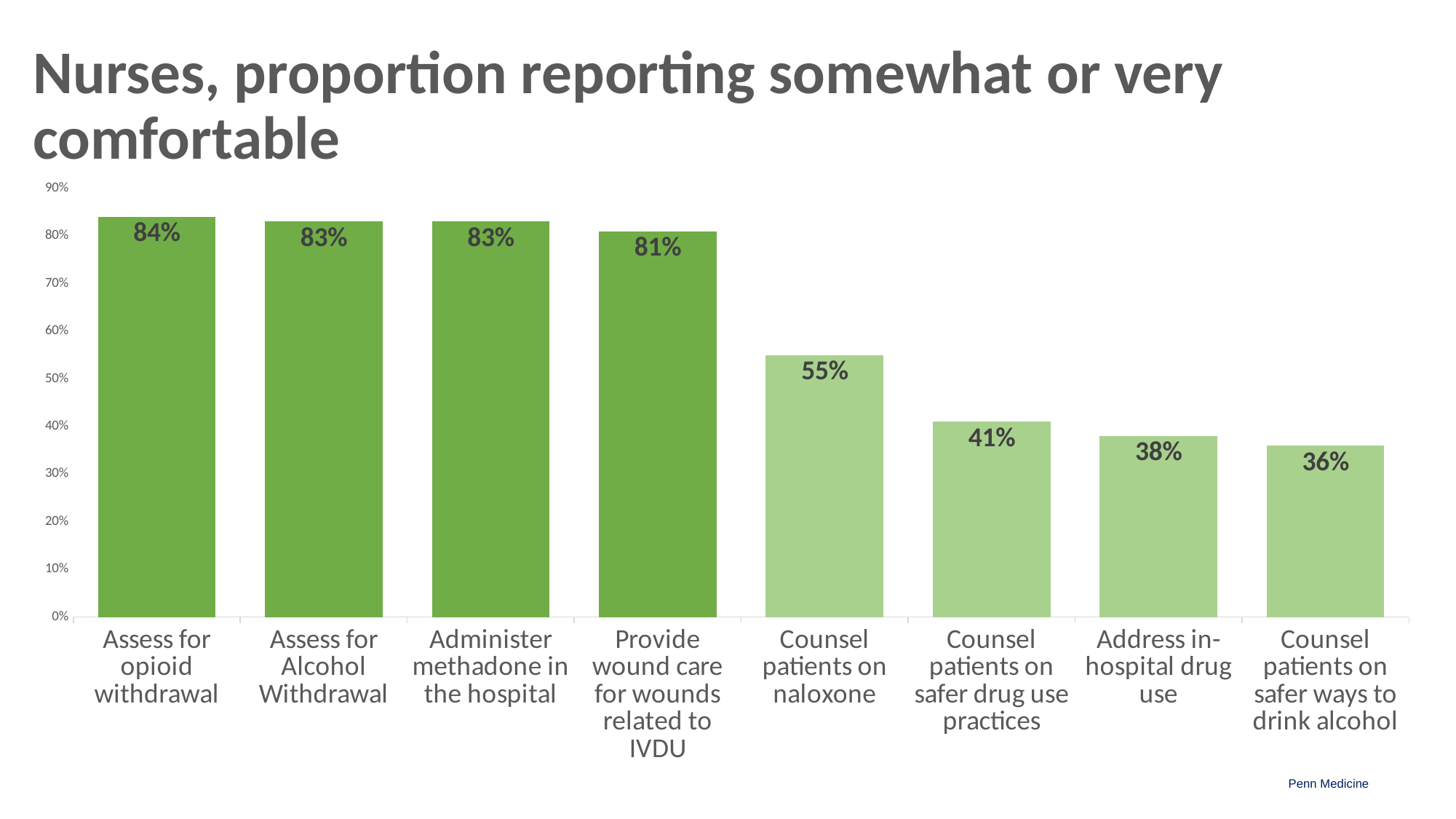
Do the values rise or fall moving from left to right along the x axis? Fall What is the difference between the values for 'Provide wound care for wounds related to IVDU' and 'Counsel patients on naloxone'? 26% What is the value for 'Counsel patients on safer ways to drink alcohol'? 36% What is the title of the chart? Nurses, proportion reporting somewhat or very comfortable What kind of chart is shown on the slide? Bar chart Is the value for 'Administer methadone in the hospital' greater or less than 80%? greater How many categories are shown on the chart? 8 What is the value for 'Counsel patients on naloxone'? 55% Which category has the highest proportion of nurses reporting comfort? Assess for opioid withdrawal Which category has the lowest proportion of nurses reporting comfort? Counsel patients on safer ways to drink alcohol What proportion of nurses reported being somewhat or very comfortable with assessing for opioid withdrawal? 84% Which is larger: the value for 'Counsel patients on safer drug use practices' or 'Address in-hospital drug use'? Counsel patients on safer drug use practices